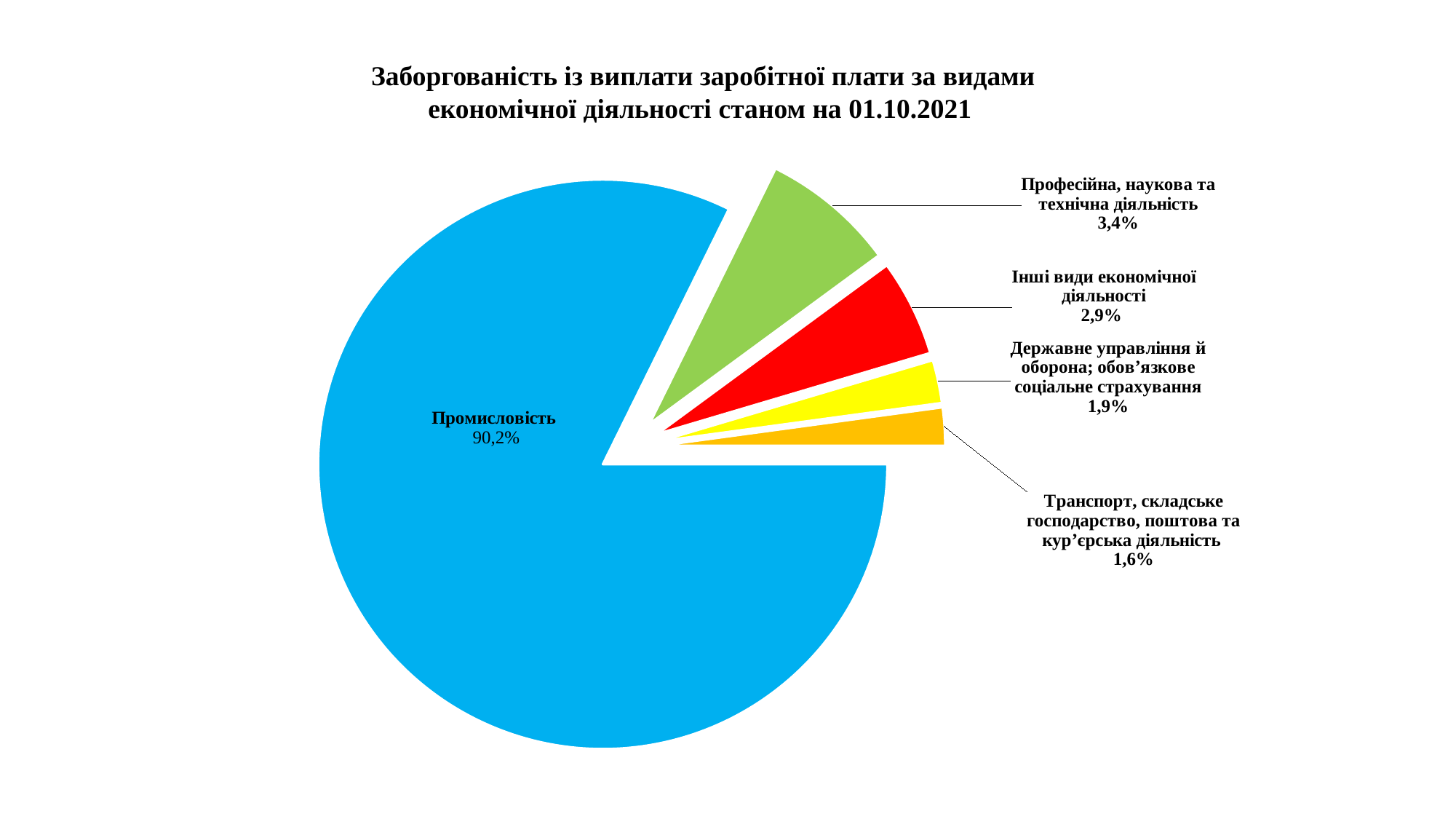
Which is larger: Державне управління й оборона; обов’язкове соціальне страхування or Транспорт, складське господарство, поштова та кур’єрська діяльність? Державне управління й оборона; обов’язкове соціальне страхування How many slices does the pie chart have? 5 What is the value for Професійна, наукова та технічна діяльність? 3,4% What is the value for Інші види економічної діяльності? 2,9% What is the value for Державне управління й оборона; обов’язкове соціальне страхування? 1,9% Which category has the smallest slice? Транспорт, складське господарство, поштова та кур’єрська діяльність What is the difference between the values for Професійна, наукова та технічна діяльність and Інші види економічної діяльності? 0,5% What is the value for Транспорт, складське господарство, поштова та кур’єрська діяльність? 1,6% Which category has the largest slice? Промисловість What colour is the slice for Промисловість? blue What kind of chart is shown on the slide? pie chart What share of the pie does Промисловість have? 90,2%